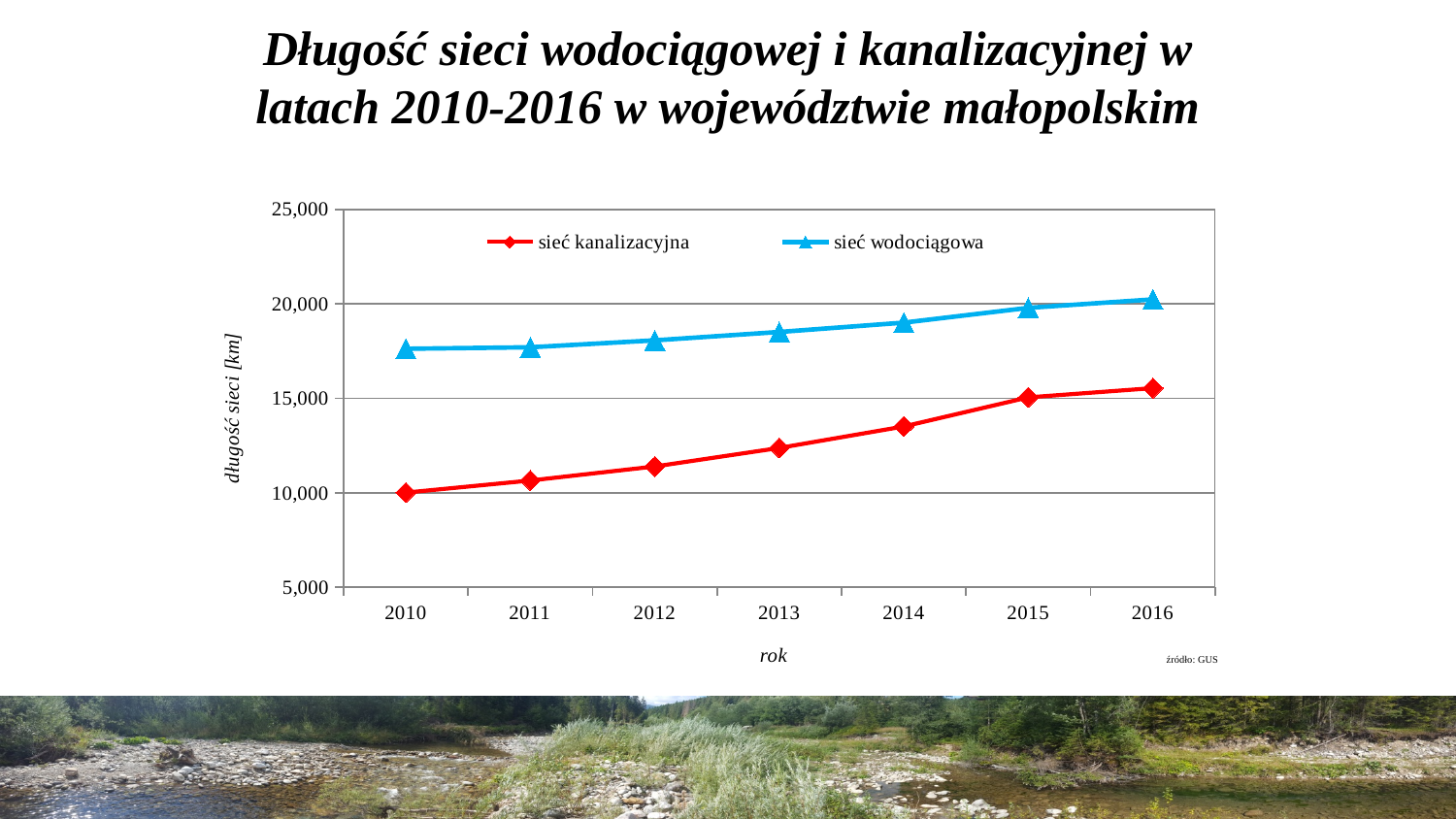
How many years are plotted along the x axis? 7 In 2014, which series has the larger value, sieć kanalizacyjna or sieć wodociągowa? sieć wodociągowa Does the value for sieć wodociągowa rise or fall from 2010 to 2016? rise Is the value for sieć kanalizacyjna in 2014 greater or less than 15,000? less What kind of chart is shown on the slide? line chart In which year is the value for sieć kanalizacyjna highest? 2016 What is the label of the y axis? długość sieci [km] Is the value for sieć wodociągowa in 2010 greater or less than 20,000? less Does the value for sieć kanalizacyjna rise or fall from 2010 to 2016? rise How many series does the legend list? 2 Is the value for sieć kanalizacyjna in 2012 greater or less than 10,000? greater In which year is the value for sieć kanalizacyjna lowest? 2010